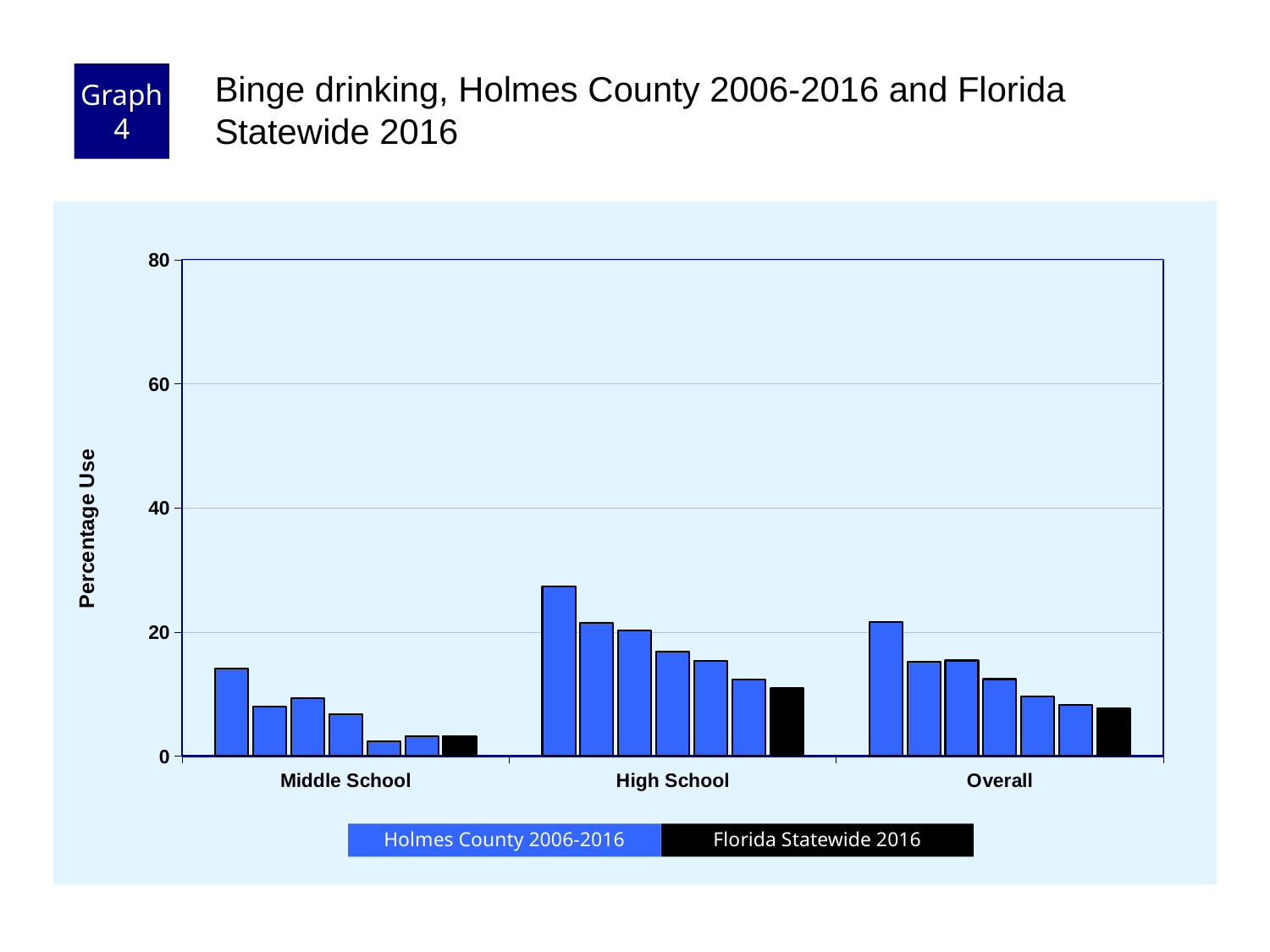
What kind of chart is shown on the slide? bar chart Is the Florida Statewide 2016 value for Middle School greater or less than 20? less Which category contains the tallest bar in the chart? High School Is the Florida Statewide 2016 value for Overall greater or less than 20? less Is the tallest Holmes County bar for High School greater or less than 20? greater How many series does the legend list? 2 Within the High School category, do the Holmes County bars rise or fall from left to right? fall Which is larger, the Florida Statewide 2016 value for High School or for Middle School? High School How many categories are shown on the x axis? 3 What is the label of the y axis? Percentage Use Which series is shown in black in the legend? Florida Statewide 2016